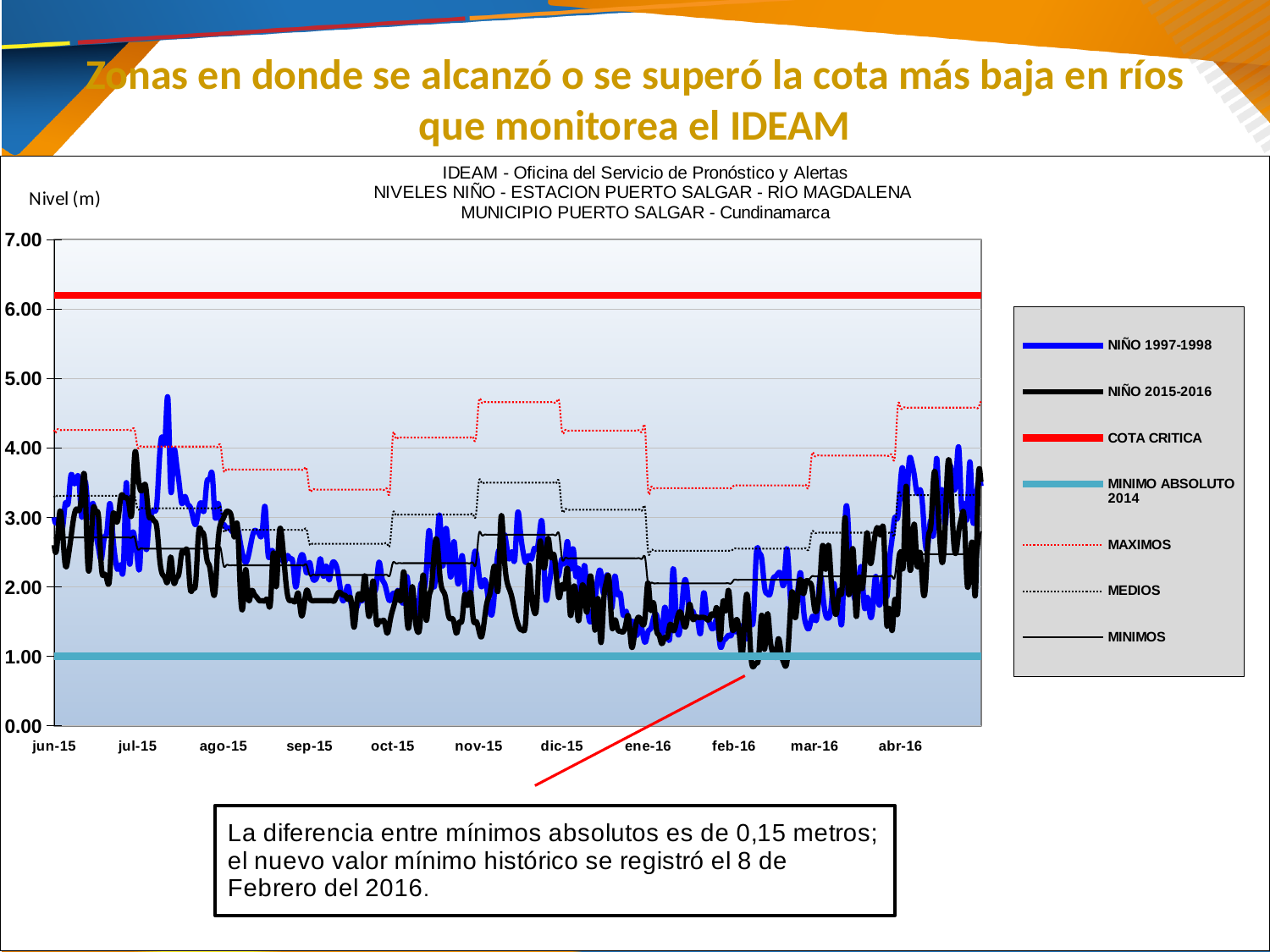
Which series sits highest on the chart across the whole period? COTA CRITICA What is the label of the y axis? Nivel (m) How many month labels are shown on the x axis? 11 According to the text box, what is the difference between the absolute minimums? 0,15 metros Around feb-16, is the lowest value of the NIÑO 2015-2016 line greater or less than 2.00? less Is the value of the MINIMO ABSOLUTO 2014 line greater or less than 2.00? less Is the value of the COTA CRITICA line greater or less than 5.00? greater Which line is higher, COTA CRITICA or MINIMO ABSOLUTO 2014? COTA CRITICA How many series does the legend list? 7 Which series sits lowest on the chart across the whole period? MINIMO ABSOLUTO 2014 What kind of chart is shown on the slide? Line chart